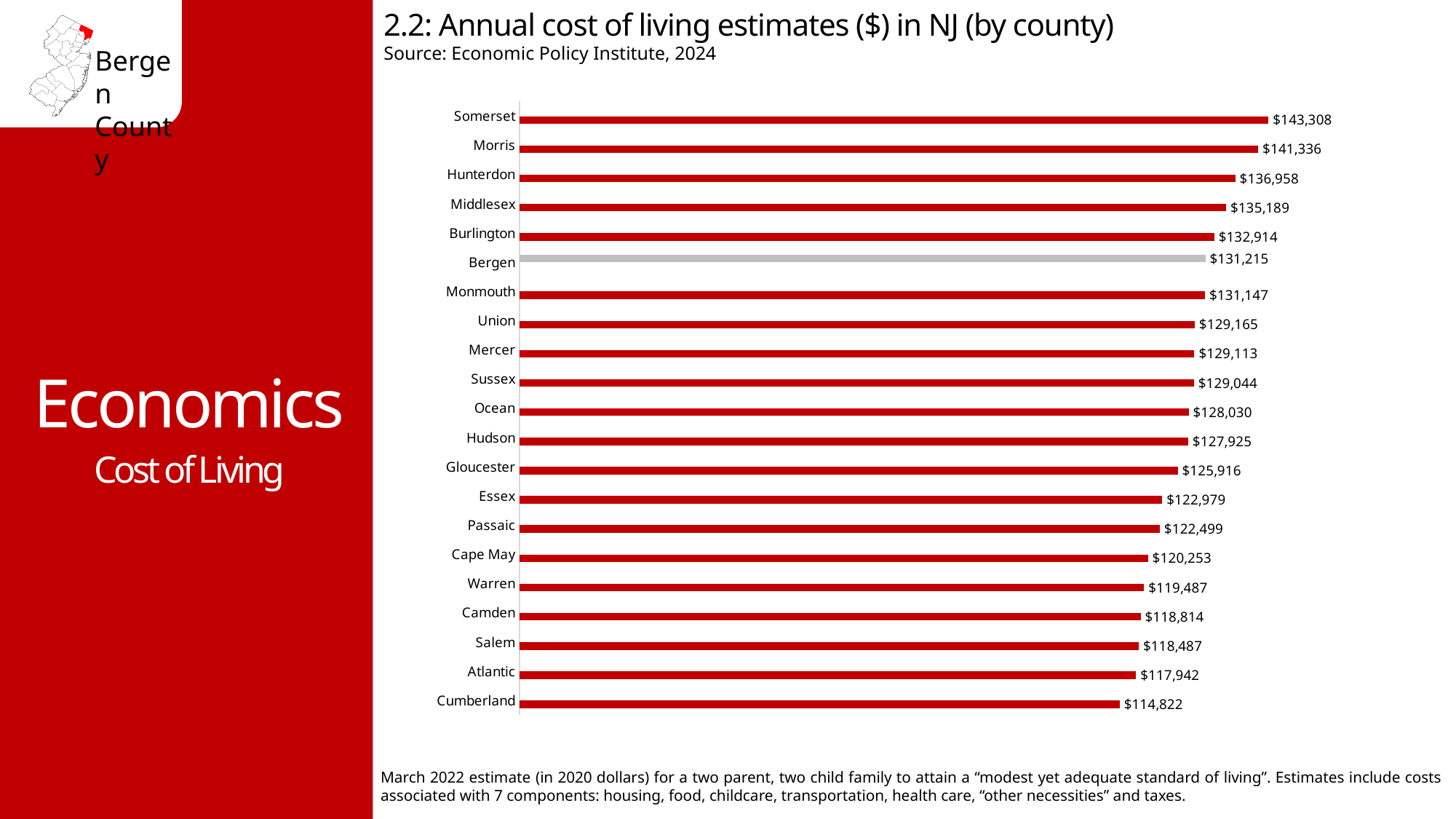
Which county has a higher cost of living estimate, Hunterdon or Essex? Hunterdon How many counties are shown in the chart? 21 Which county has the highest annual cost of living estimate? Somerset Which county's bar is shown in grey rather than red? Bergen What is the annual cost of living estimate for Bergen County? $131,215 What is the difference between the cost of living estimates for Somerset and Morris counties? $1,972 What is the difference between the cost of living estimates for Somerset and Cumberland counties? $28,486 What type of chart is used to show the annual cost of living estimates? Bar chart What is the annual cost of living estimate for Hudson County? $127,925 Which county has a higher cost of living estimate, Bergen or Monmouth? Bergen Which county has the lowest annual cost of living estimate? Cumberland What is the annual cost of living estimate for Cape May County? $120,253